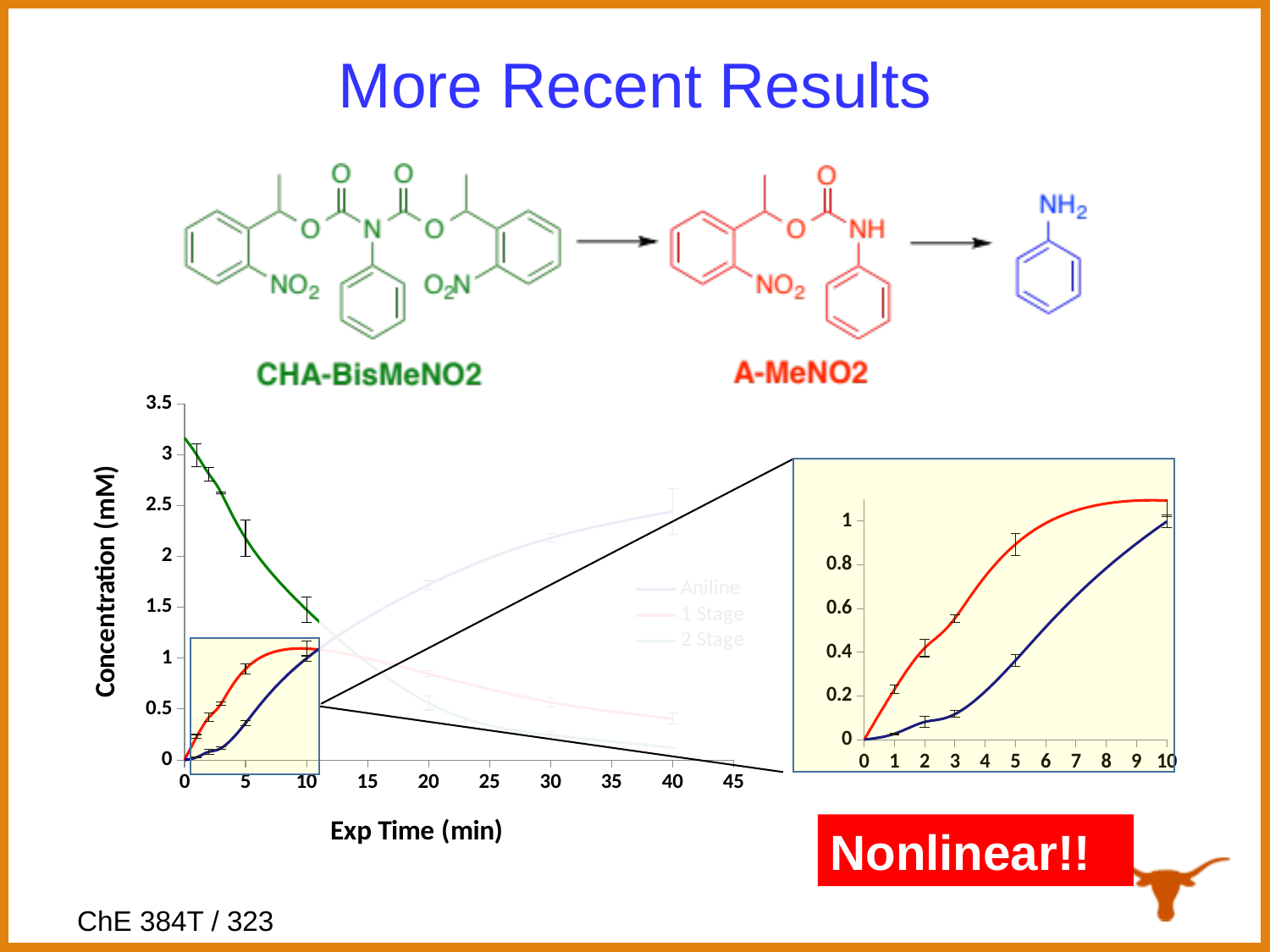
In the inset chart on the right, is the value of the blue line at 3 min greater or less than 0.2? less What is the y-axis title of the main chart? Concentration (mM) In the main chart, is the value of the green (2 Stage) line at 5 min greater or less than 1.5? greater In the main chart, does the red (1 Stage) line rise or fall between 0 and 10 min? rise In the main chart, at 10 min, which is larger: the green (2 Stage) line or the red (1 Stage) line? green (2 Stage) In the main chart, is the value of the green (2 Stage) line at 0 min greater or less than 3? greater In the inset chart on the right, at 5 min, which is larger: the red line or the blue line? red line What is the x-axis title of the main chart? Exp Time (min) In the main chart, does the green (2 Stage) line rise or fall as Exp Time increases? fall How many series does the legend of the main chart list? 3 What kind of chart is the main chart on the left of the slide? line chart